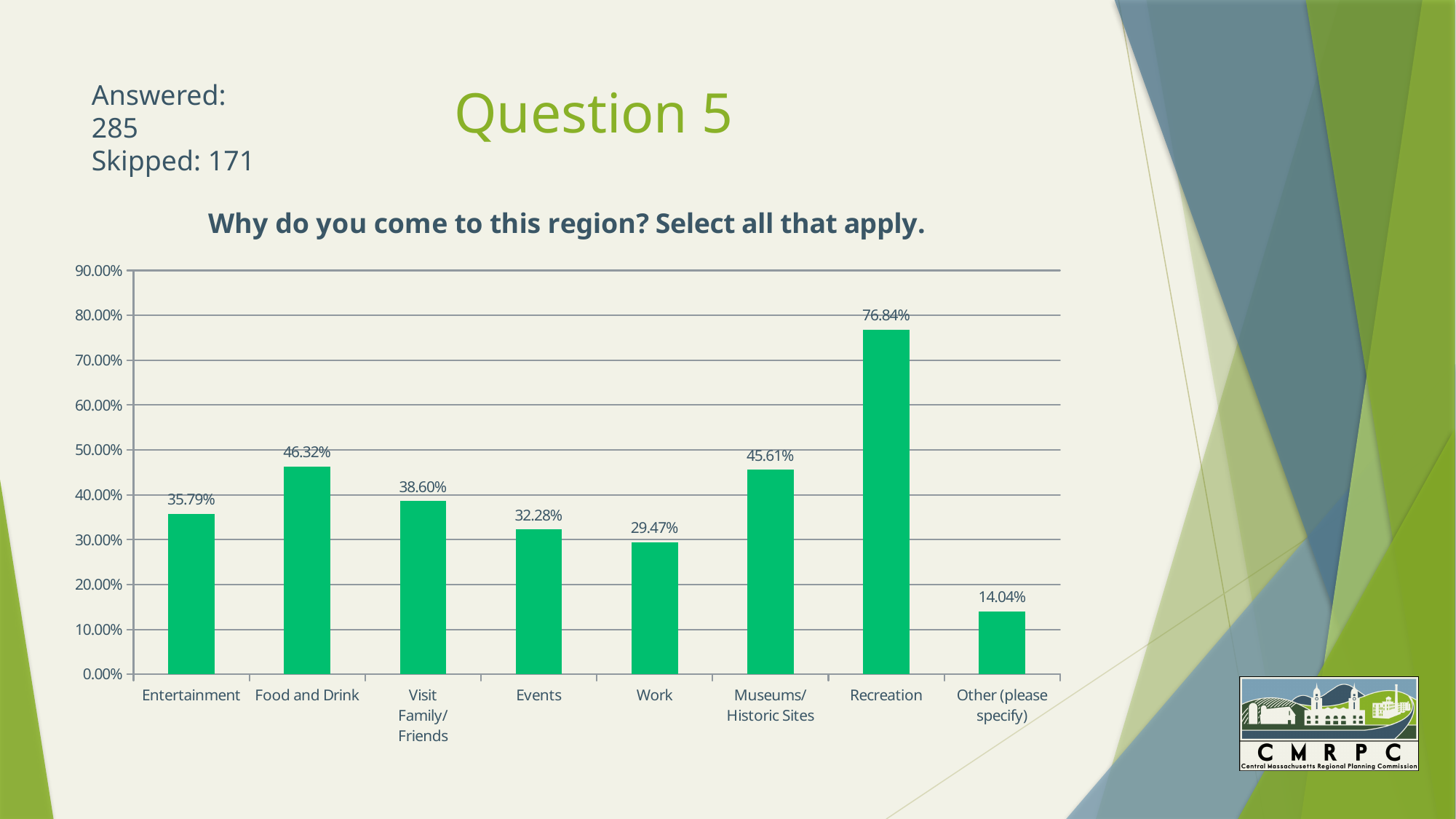
What is the title of the chart? Why do you come to this region? Select all that apply. What kind of chart is shown on the slide? bar chart What is the difference between the values for Food and Drink and Museums/Historic Sites? 0.71% How many categories are shown on the x axis? 8 Which is larger, the value for Entertainment or the value for Visit Family/Friends? Visit Family/Friends What is the value for Food and Drink? 46.32% Is the value for Events greater or less than 40.00%? less What is the difference between the values for Recreation and Other (please specify)? 62.80% What is the value for Work? 29.47% What is the value for Recreation? 76.84% Which category has the lowest value? Other (please specify) Which category has the highest value? Recreation